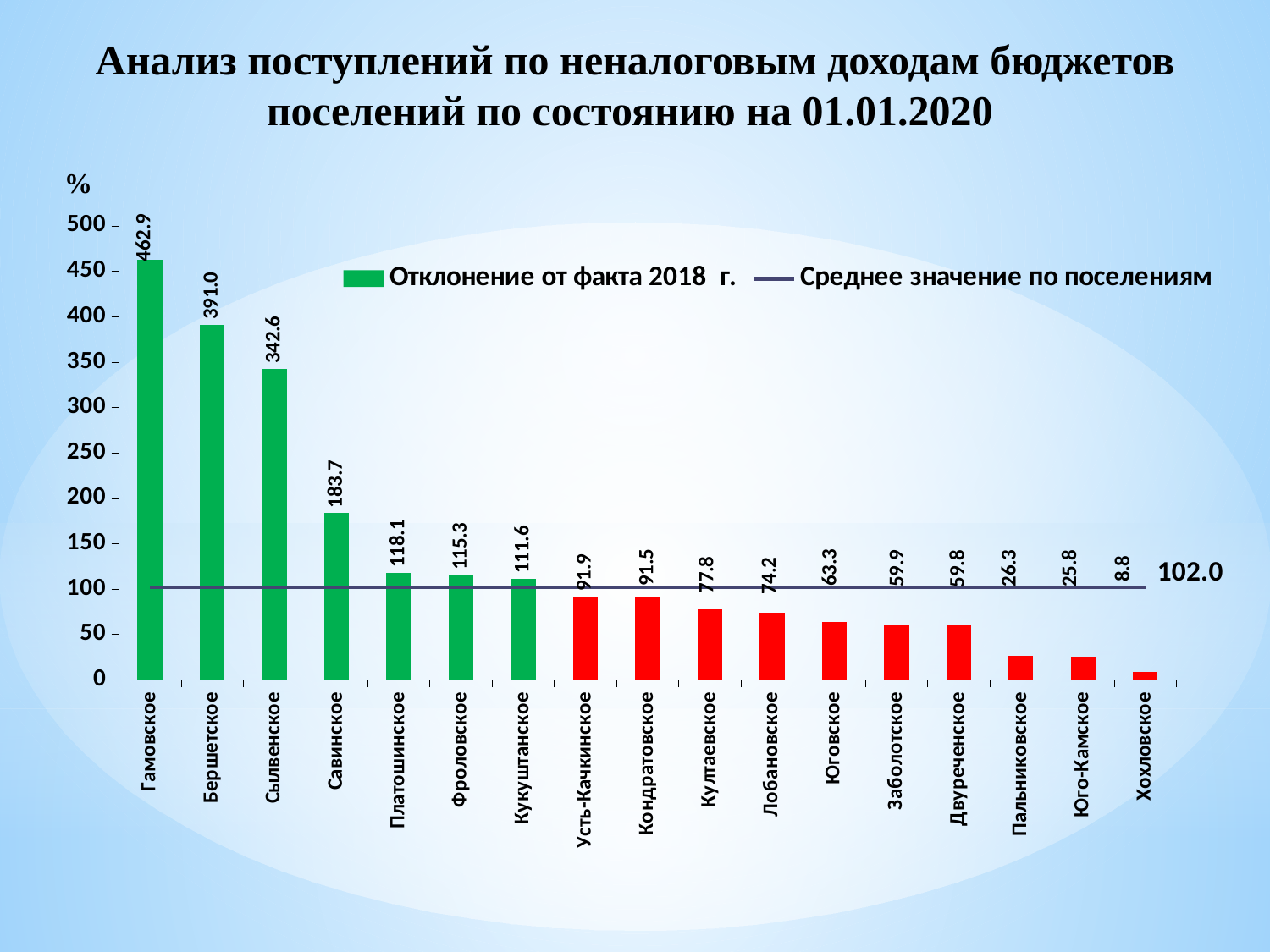
Is the value for Култаевское greater or less than 100? less What is the value for Савинское? 183.7 Which category has the highest value? Гамовское What is the value of the average line (Среднее значение по поселениям)? 102.0 How many series does the legend list? 2 Which is larger, the value for Платошинское or the value for Фроловское? Платошинское What is the difference between the values for Бершетское and Сылвенское? 48.4 What is the value for Кондратовское? 91.5 What kind of chart is shown on the slide? A bar chart combined with a line (the average line) — a combination bar and line chart Which category has the lowest value? Хохловское How many categories (settlements) are shown on the x axis? 17 What is the value for Гамовское? 462.9